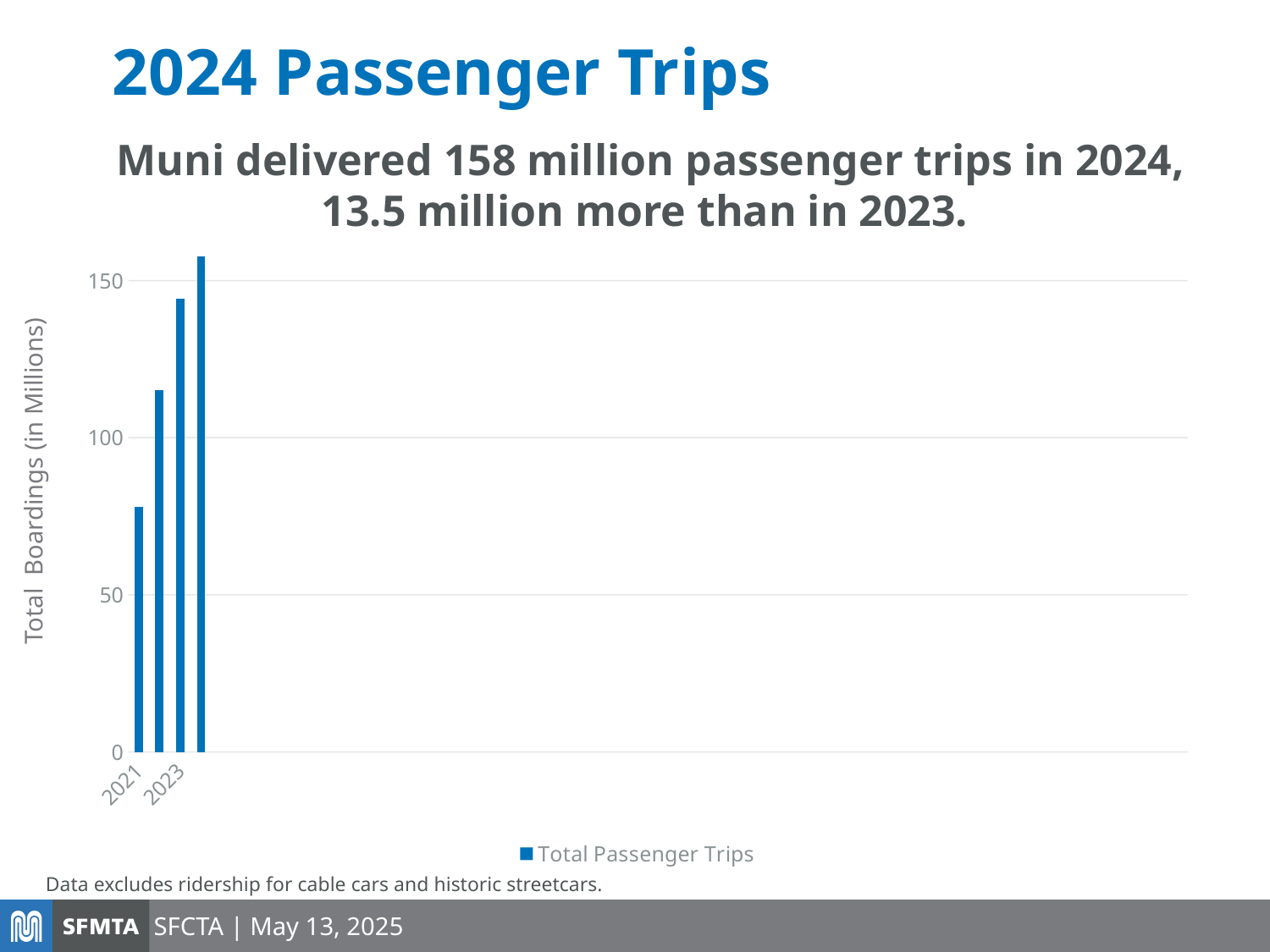
Is the value for 2023 greater or less than 100? greater What is the title of the vertical axis? Total Boardings (in Millions) Do the bar values rise or fall from left to right along the x axis? rise What kind of chart is shown on the slide? bar chart Is the value for 2023 greater or less than 150? less How many bars are plotted in the chart? 4 Is the value of the rightmost bar greater or less than 150? greater Which labeled year has the lowest bar? 2021 Which has the larger value, 2021 or 2023? 2023 What series name is shown in the chart legend? Total Passenger Trips How many series does the chart legend list? 1